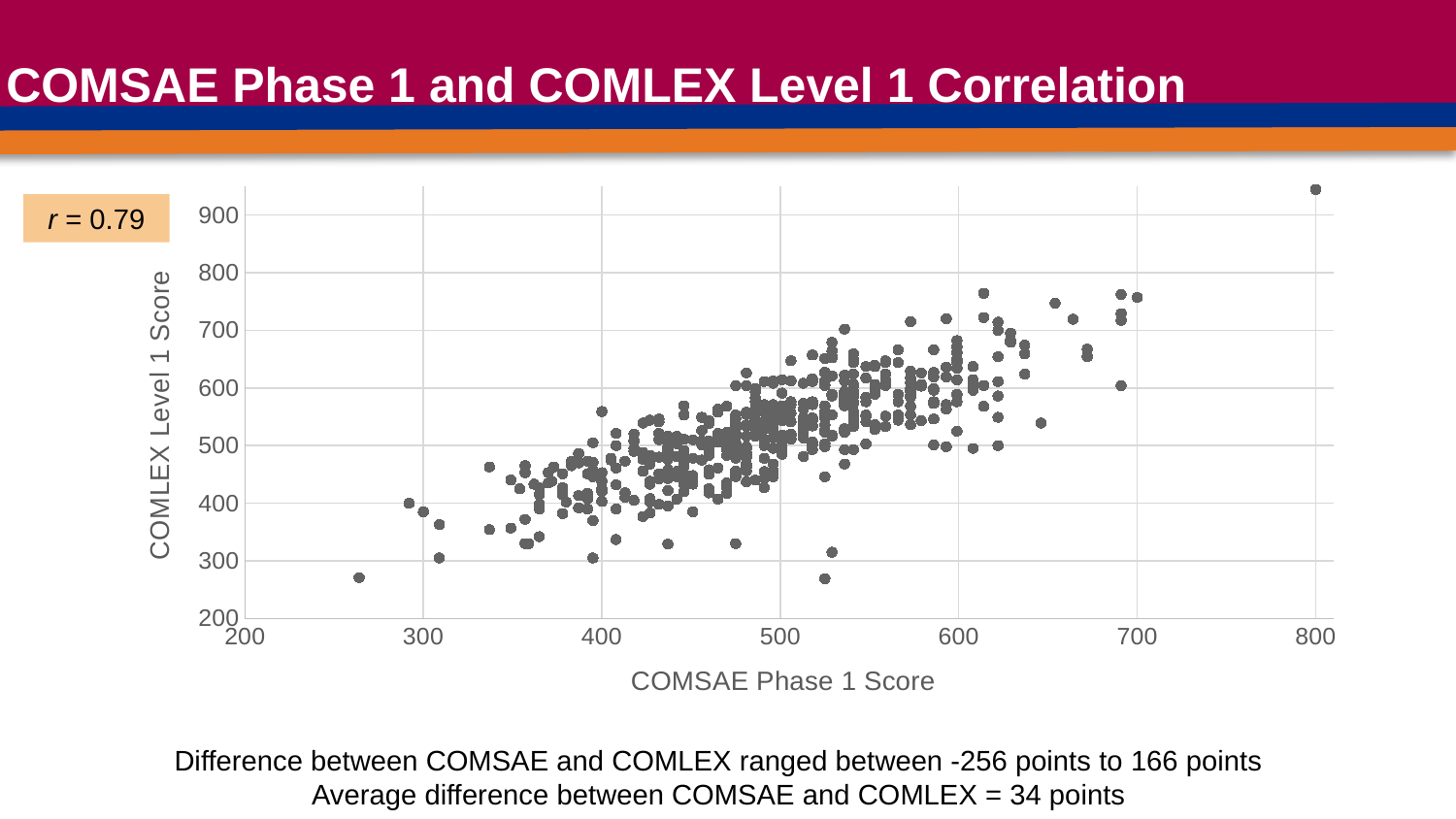
Is the highest COMLEX Level 1 Score plotted on the chart greater or less than 900? greater What is the title of the chart on the slide? COMSAE Phase 1 and COMLEX Level 1 Correlation Is the lowest COMSAE Phase 1 Score plotted on the chart greater or less than 300? less What correlation coefficient (r) is shown on the chart? r = 0.79 What kind of chart is shown on the slide? scatter plot As COMSAE Phase 1 Score increases along the x axis, do COMLEX Level 1 Scores generally rise or fall? rise Is the highest COMSAE Phase 1 Score plotted on the chart greater or less than 700? greater